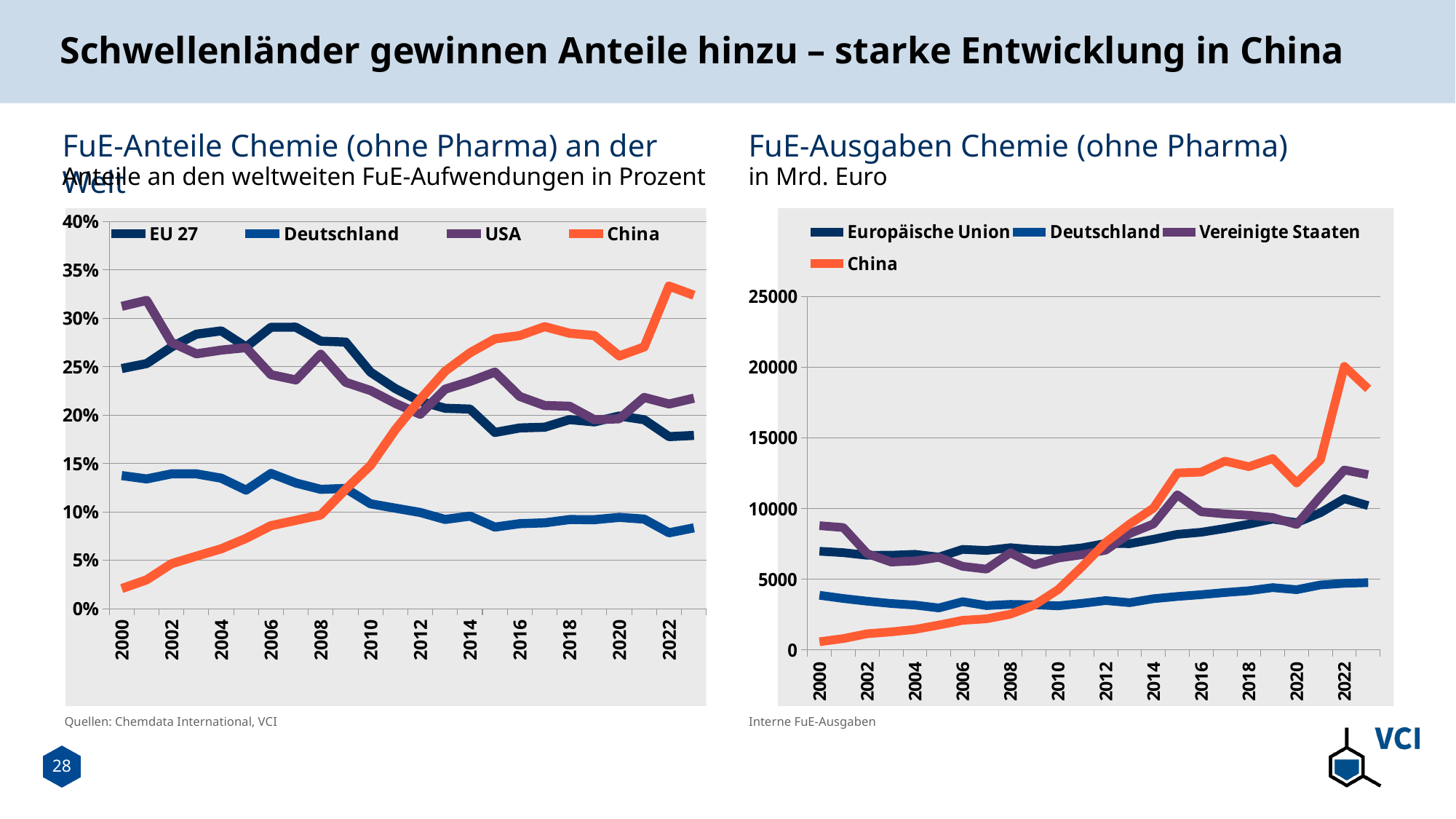
In the left chart, is the value for China in 2022 greater or less than 30%? greater In the left chart, does the share for Deutschland rise or fall from 2000 to 2022? fall Which series are listed in the legend of the right chart? Europäische Union, Deutschland, Vereinigte Staaten, China In the left chart, is the value for Deutschland in 2022 greater or less than 10%? less How many series does the legend of the left chart list? 4 In the left chart, is the value for USA in 2000 greater or less than 30%? greater What kind of chart is the right chart, 'FuE-Ausgaben Chemie (ohne Pharma)'? line chart What kind of chart is the left chart, 'FuE-Anteile Chemie (ohne Pharma) an der Welt'? line chart In the left chart, which is larger in 2022: the value for China or the value for EU 27? China In the right chart, does the value for China rise or fall from 2000 to 2022? rise